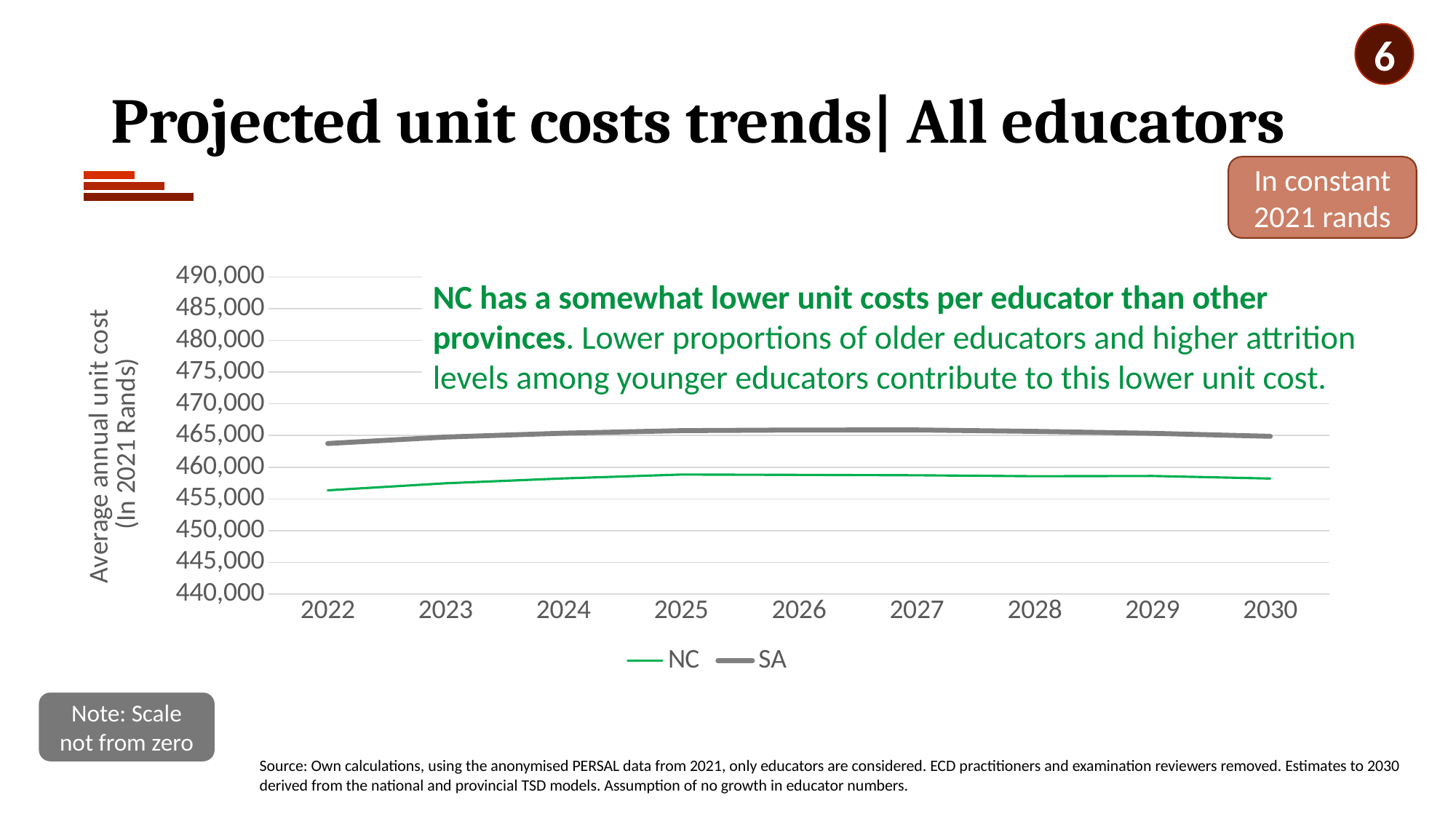
Does the NC line rise or fall between 2022 and 2025? rise Is the value for NC in 2025 greater or less than 460,000? less How many series does the chart legend list? 2 Is the value for NC in 2022 greater or less than 455,000? greater What is the title of the y axis of the chart? Average annual unit cost (In 2021 Rands) Is the value for SA in 2022 greater or less than 465,000? less How many years are plotted along the x axis of the chart? 9 What kind of chart is shown on the slide? line chart Which colour is used for the SA series in the chart? grey Which series has the higher value in 2025, NC or SA? SA